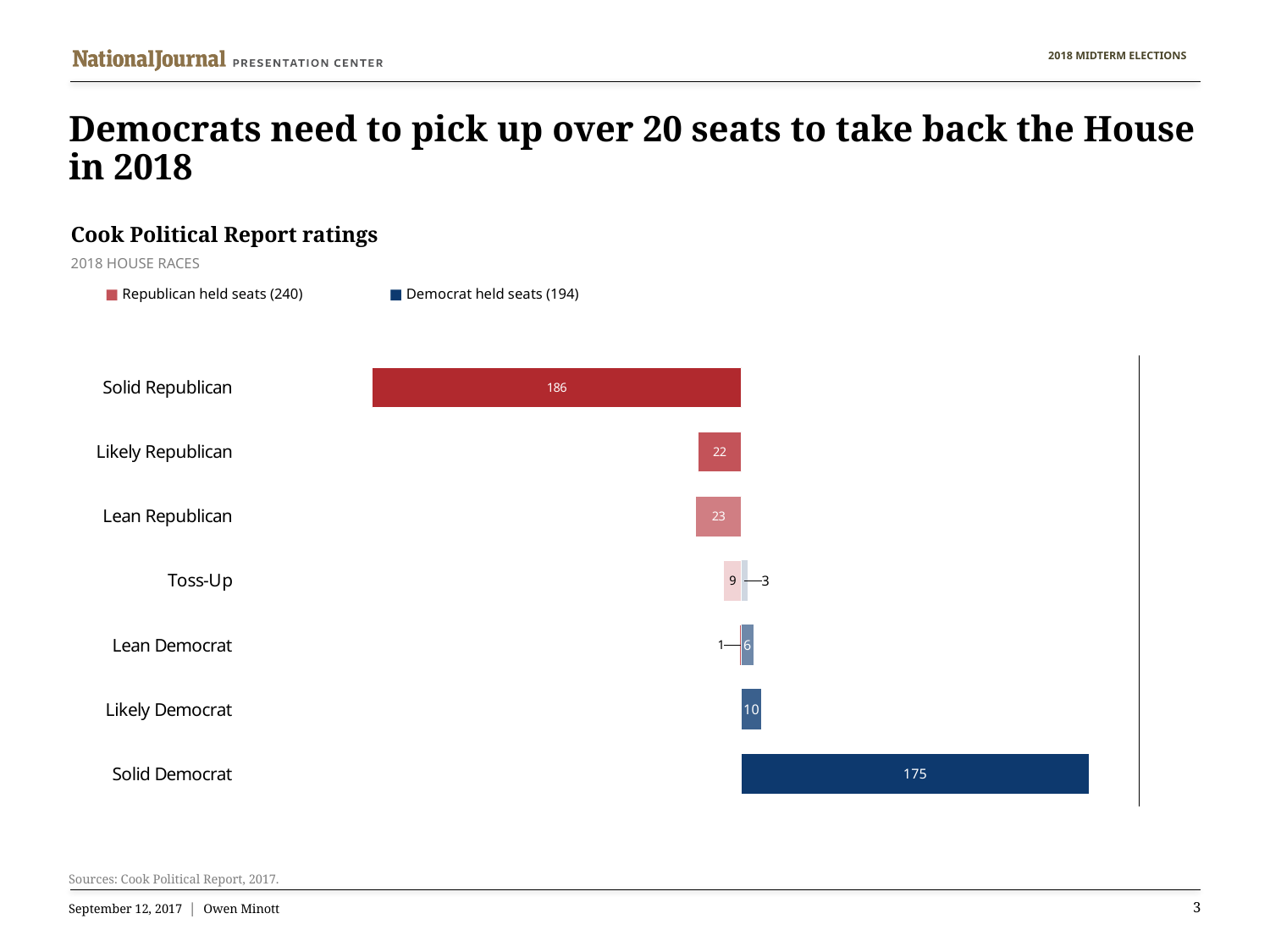
Which is larger, Lean Republican or Likely Republican? Lean Republican How many series does the legend list? 2 What is the difference between Solid Republican and Solid Democrat? 11 How many Republican held seats are rated Toss-Up? 9 What is the total number of seats rated Toss-Up across both parties? 12 What is the value for Likely Republican? 22 How many rating categories are shown on the chart? 7 What is the value for Solid Republican? 186 Which category has the highest value? Solid Republican What is the value for Solid Democrat? 175 What kind of chart is shown? Bar chart How many Democrat held seats are rated Toss-Up? 3